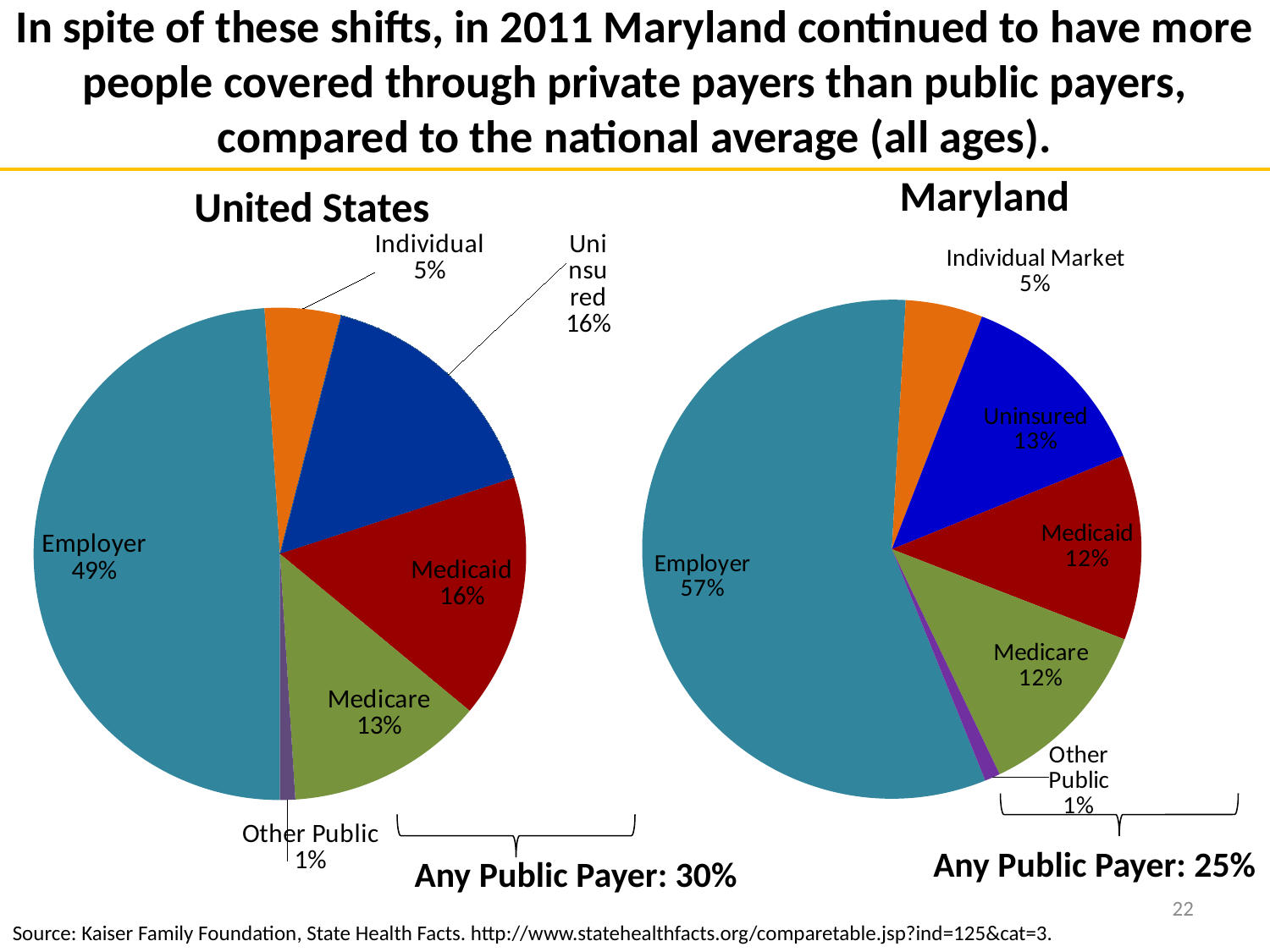
Which is larger: Medicaid in the United States chart or Medicaid in the Maryland chart? United States In the Maryland chart, which category has the smallest slice? Other Public In the United States chart, which category has the largest slice? Employer In the Maryland chart, what is the value for Uninsured? 13% In the United States chart, what share of the pie is Employer? 49% According to the annotation under the Maryland chart, what is the Any Public Payer share? 25% In the Maryland chart, what is the value for Medicaid? 12% How many slices does the Maryland pie chart have? 6 What is the difference between the Employer share in the Maryland chart and the Employer share in the United States chart? 8% In the United States chart, what is the value for Uninsured? 16% What type of chart is the United States chart? Pie chart In the Maryland chart, what share of the pie is Employer? 57%